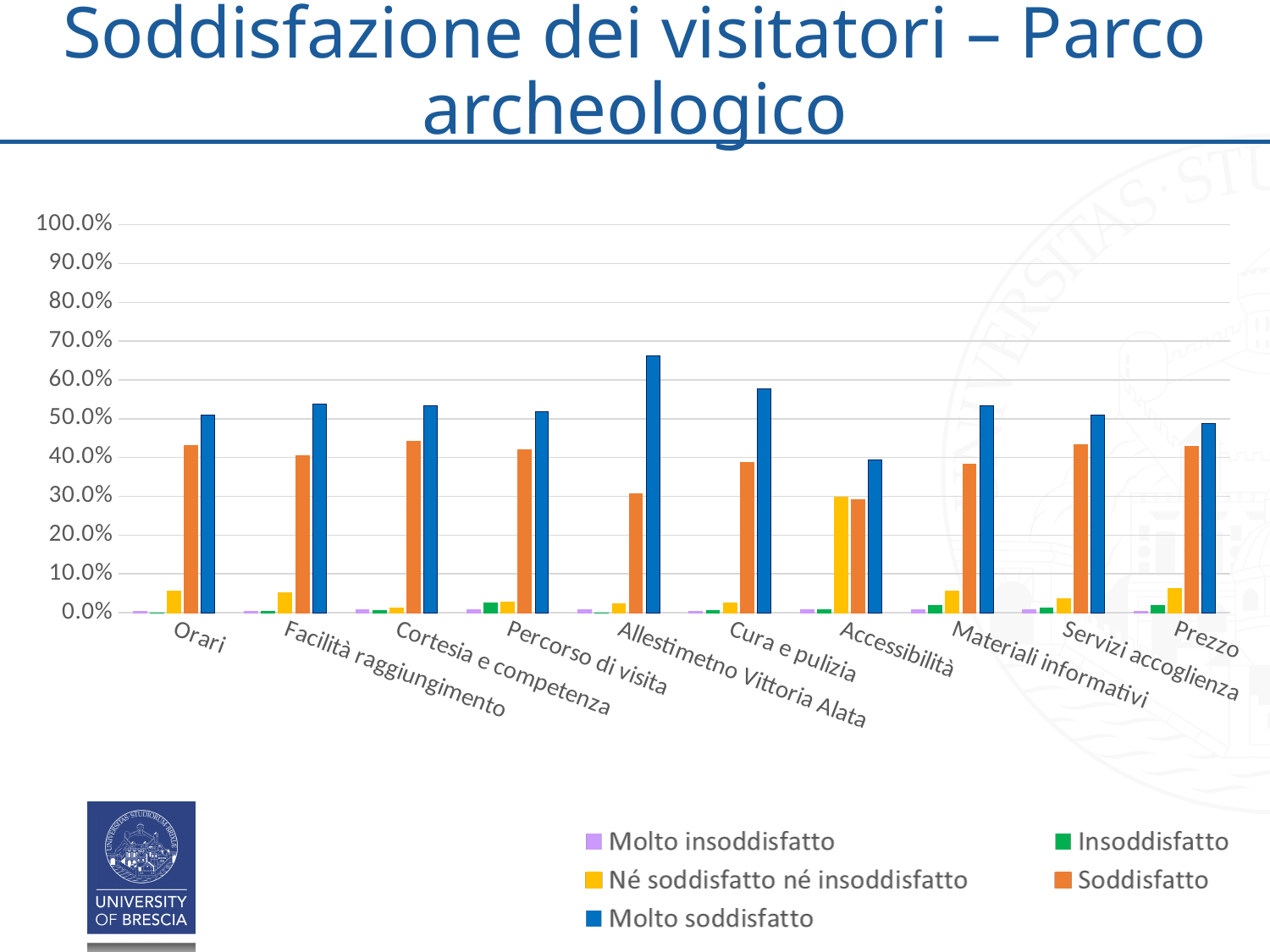
How many categories are shown on the x axis of the chart? 10 How many series does the legend list? 5 Which category has the lowest value for the 'Soddisfatto' series? Accessibilità Which category has the highest value for the 'Né soddisfatto né insoddisfatto' series? Accessibilità Is the 'Molto soddisfatto' value for Allestimetno Vittoria Alata greater or less than 60.0%? greater What kind of chart is shown on the slide? bar chart What is the title of the slide containing the chart? Soddisfazione dei visitatori – Parco archeologico Is the 'Molto soddisfatto' value for Accessibilità greater or less than 50.0%? less Which category has the highest value for the 'Molto soddisfatto' series? Allestimetno Vittoria Alata For Cura e pulizia, which is larger: the 'Molto soddisfatto' value or the 'Soddisfatto' value? Molto soddisfatto Which category has the lowest value for the 'Molto soddisfatto' series? Accessibilità Is the 'Né soddisfatto né insoddisfatto' value for Accessibilità greater or less than 20.0%? greater